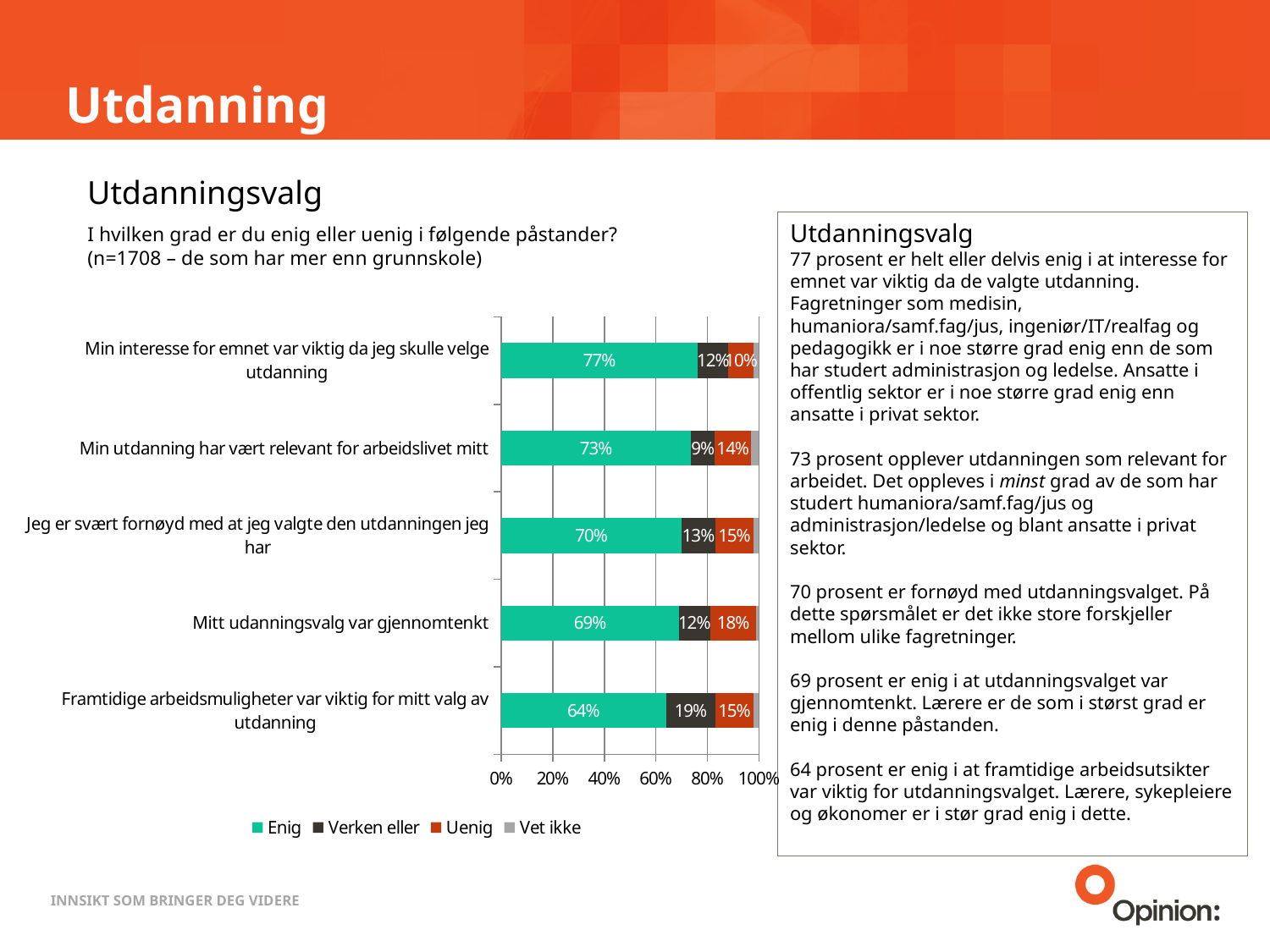
What is the Uenig value for "Mitt udanningsvalg var gjennomtenkt"? 18% How many series does the legend list? 4 What kind of chart is shown on the slide? Stacked bar chart Which statement has the highest Enig share? Min interesse for emnet var viktig da jeg skulle velge utdanning Which series is shown in green in the chart? Enig Which is larger: the Uenig value for "Mitt udanningsvalg var gjennomtenkt" or for "Min utdanning har vært relevant for arbeidslivet mitt"? Mitt udanningsvalg var gjennomtenkt Which statement has the lowest Enig share? Framtidige arbeidsmuligheter var viktig for mitt valg av utdanning How many statements are shown in the chart? 5 What is the difference between the Enig values for "Min interesse for emnet var viktig da jeg skulle velge utdanning" and "Framtidige arbeidsmuligheter var viktig for mitt valg av utdanning"? 13% What is the Enig value for "Min utdanning har vært relevant for arbeidslivet mitt"? 73% What is the Enig value for "Jeg er svært fornøyd med at jeg valgte den utdanningen jeg har"? 70% What is the Verken eller value for "Framtidige arbeidsmuligheter var viktig for mitt valg av utdanning"? 19%